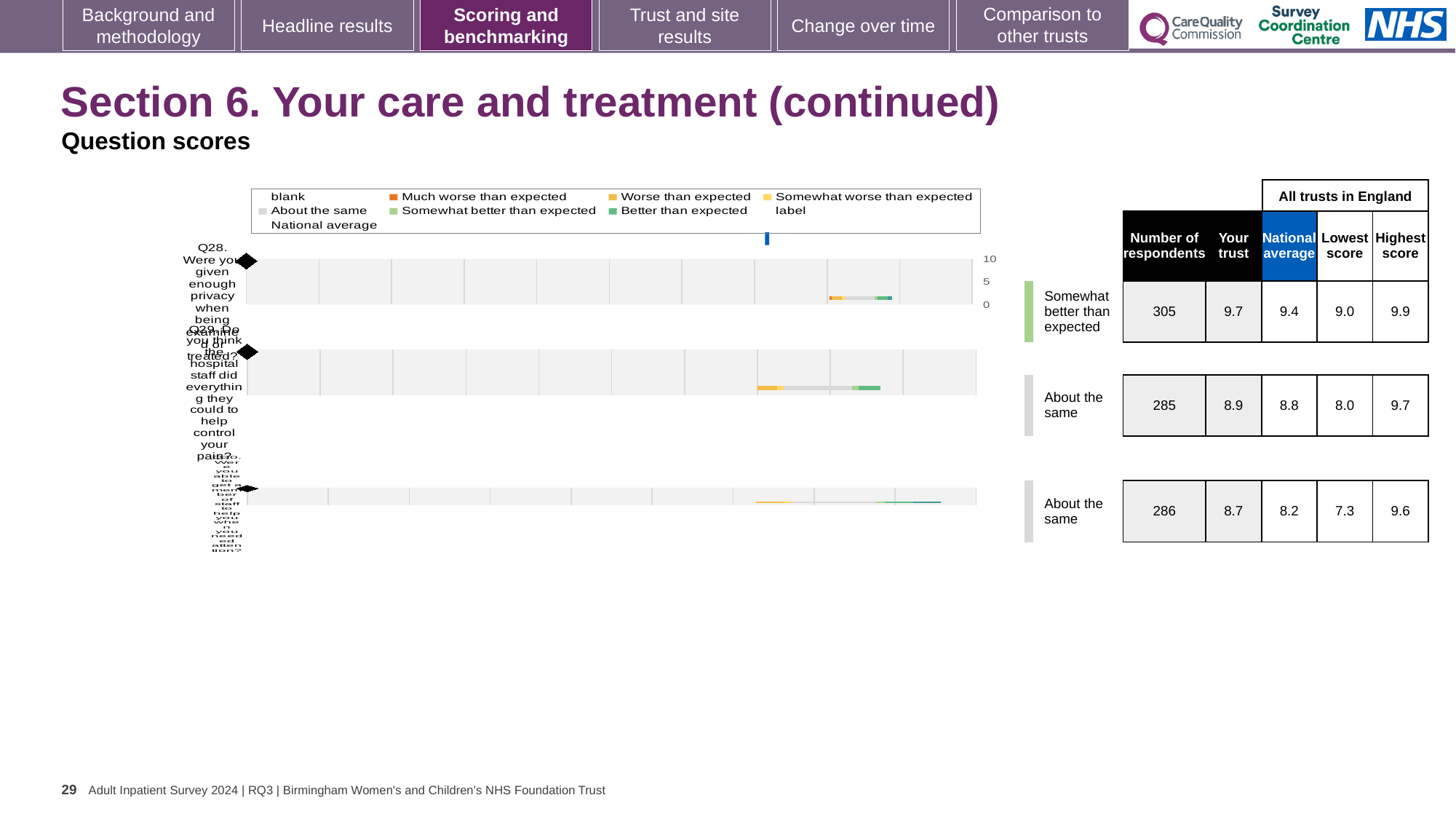
What is the difference between the 'Your trust' score and the national average for Q28? 0.3 How many respondents are shown for Q28? 305 What is the 'Your trust' score shown for Q28 (privacy when being examined or treated)? 9.7 Which question has the lowest 'Your trust' score? Q30 How many survey questions (rows) are plotted in the chart? 3 What is the highest value shown on the chart's score axis? 10 Which question has the highest 'Your trust' score? Q28 For Q30, which is larger: the 'Your trust' score or the national average? Your trust What benchmark category is shown for Q28? Somewhat better than expected What is the national average score shown for Q29 (hospital staff helping control pain)? 8.8 What kind of chart is shown on the slide? bar chart What is the lowest score among all trusts in England shown for Q30? 7.3